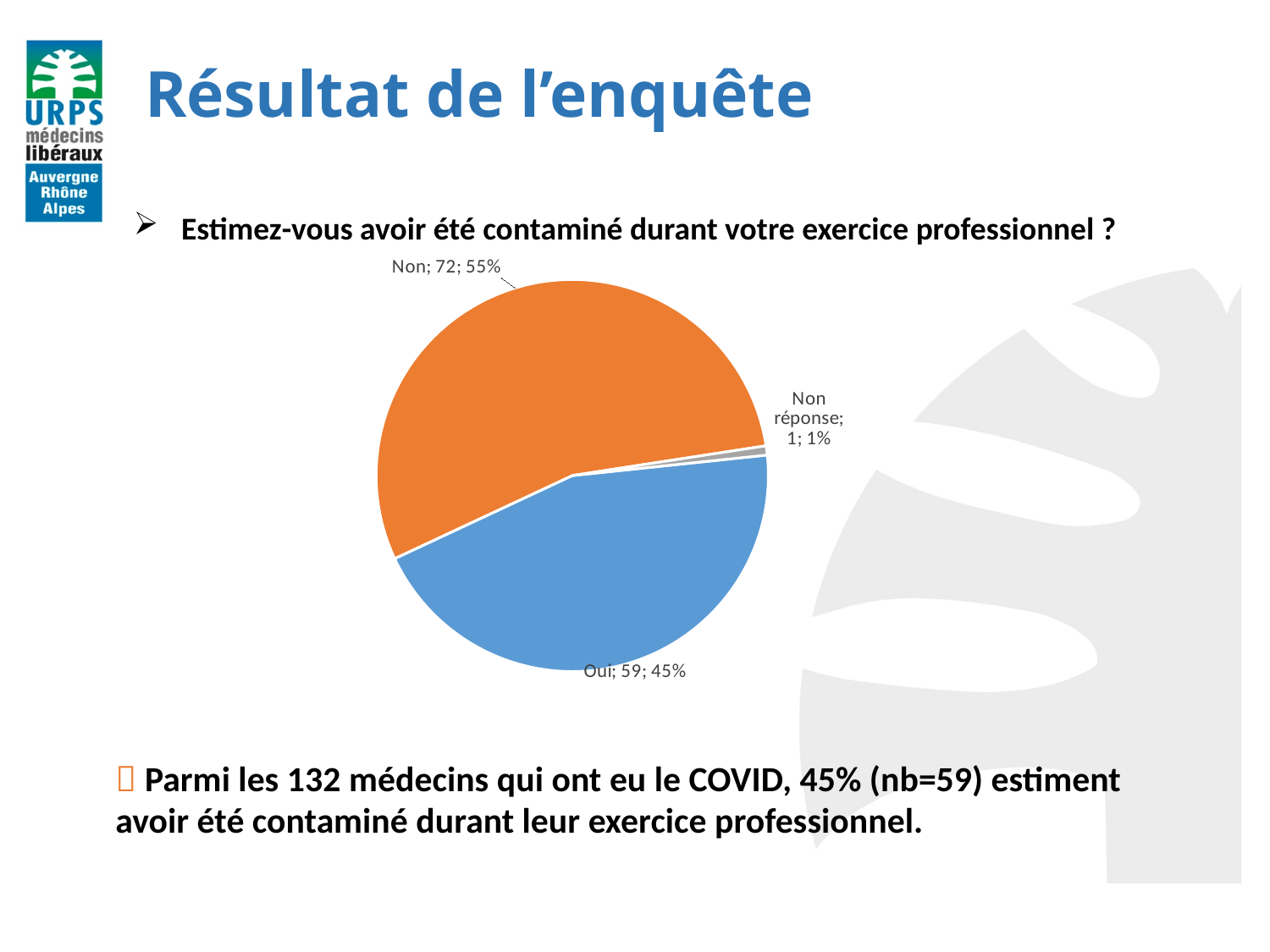
Which slice is the largest? Non How many slices does the pie chart have? 3 What share of the pie does the "Non" slice represent? 55% What is the count for the "Non" slice? 72 What is the count for the "Oui" slice? 59 What share of the pie does the "Oui" slice represent? 45% What kind of chart is shown on the slide? pie chart What is the count for the "Non réponse" slice? 1 Which is larger, the "Oui" slice or the "Non" slice? Non What is the difference between the counts for "Non" and "Oui"? 13 Which slice is the smallest? Non réponse What colour is the "Oui" slice? blue